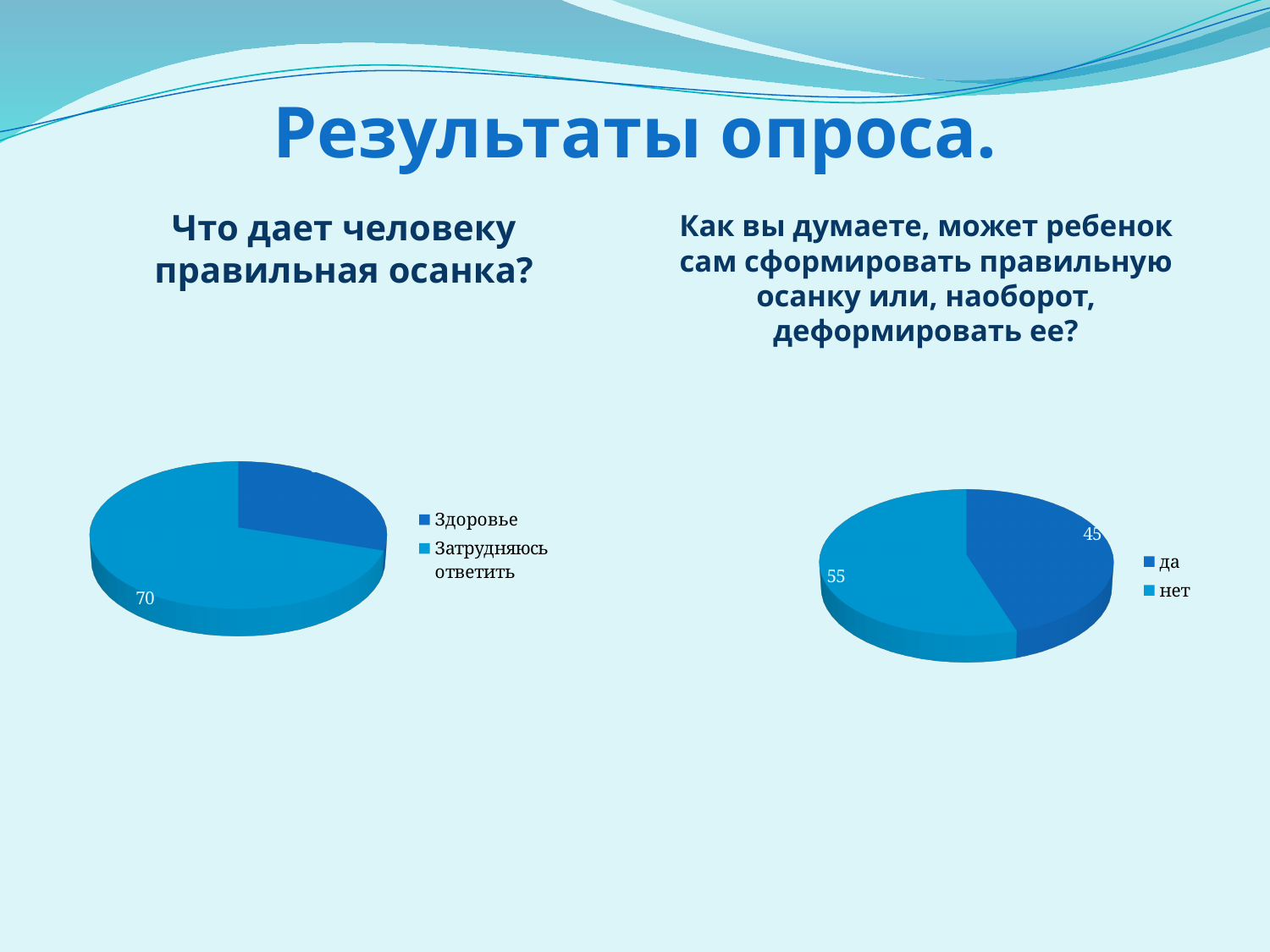
In the right chart about whether a child can form correct posture, what is the difference between the values for 'нет' and 'да'? 10 In the right chart about whether a child can form correct posture, which category has the larger slice? нет How many slices does the right chart about whether a child can form correct posture have? 2 How many charts are shown on the slide? 2 How many categories does the legend of the left chart 'Что дает человеку правильная осанка?' list? 2 What kind of chart is the left chart 'Что дает человеку правильная осанка?'? pie chart In the right chart about whether a child can form correct posture, is the value for 'да' larger or smaller than the value for 'нет'? smaller In the left chart 'Что дает человеку правильная осанка?', what value is shown for 'Затрудняюсь ответить'? 70 In the left chart 'Что дает человеку правильная осанка?', which category has the largest slice? Затрудняюсь ответить In the right chart about whether a child can form correct posture, what value is shown for 'нет'? 55 In the right chart about whether a child can form correct posture, what value is shown for 'да'? 45 In the left chart 'Что дает человеку правильная осанка?', which category has the smallest slice? Здоровье